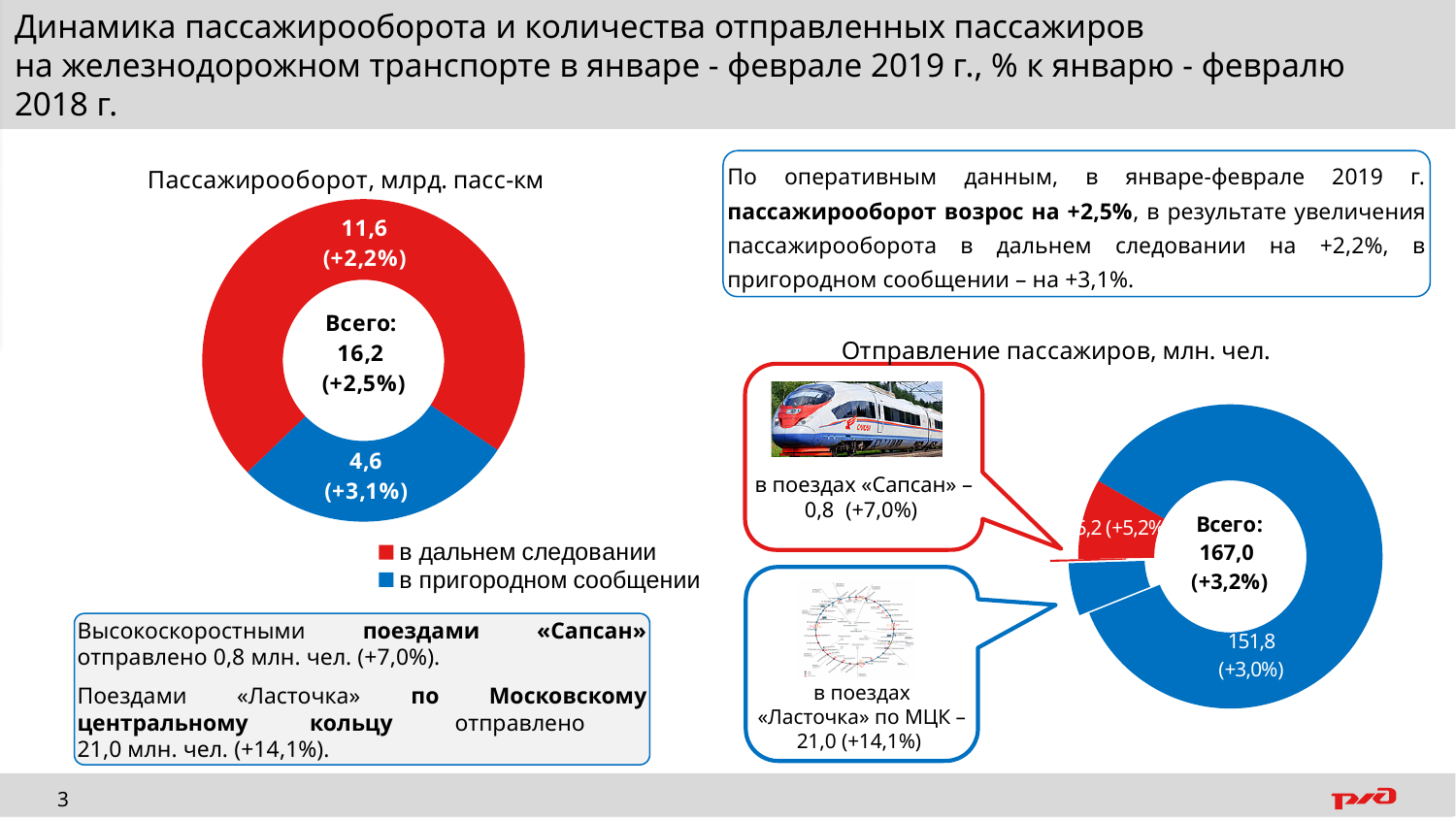
On the chart titled «Пассажирооборот, млрд. пасс-км», what percentage change is shown for «в пригородном сообщении»? +3,1% On the chart titled «Пассажирооборот, млрд. пасс-км», what total is shown in the centre of the donut? 16,2 On the chart titled «Отправление пассажиров, млн. чел.», what total is shown in the centre of the donut? 167,0 On the chart titled «Пассажирооборот, млрд. пасс-км», which category has the larger value? в дальнем следовании On the chart titled «Пассажирооборот, млрд. пасс-км», which colour represents «в пригородном сообщении»? Blue On the chart titled «Отправление пассажиров, млн. чел.», what value is shown on the blue segment? 151,8 What type of chart is the chart titled «Пассажирооборот, млрд. пасс-км»? Donut (pie) chart On the chart titled «Пассажирооборот, млрд. пасс-км», how many entries does the legend list? 2 On the chart titled «Пассажирооборот, млрд. пасс-км», what is the difference between the values for «в дальнем следовании» and «в пригородном сообщении»? 7,0 On the chart titled «Отправление пассажиров, млн. чел.», what percentage change is shown for the total? +3,2% On the chart titled «Пассажирооборот, млрд. пасс-км», what is the value for «в пригородном сообщении»? 4,6 On the chart titled «Пассажирооборот, млрд. пасс-км», what is the value for «в дальнем следовании»? 11,6